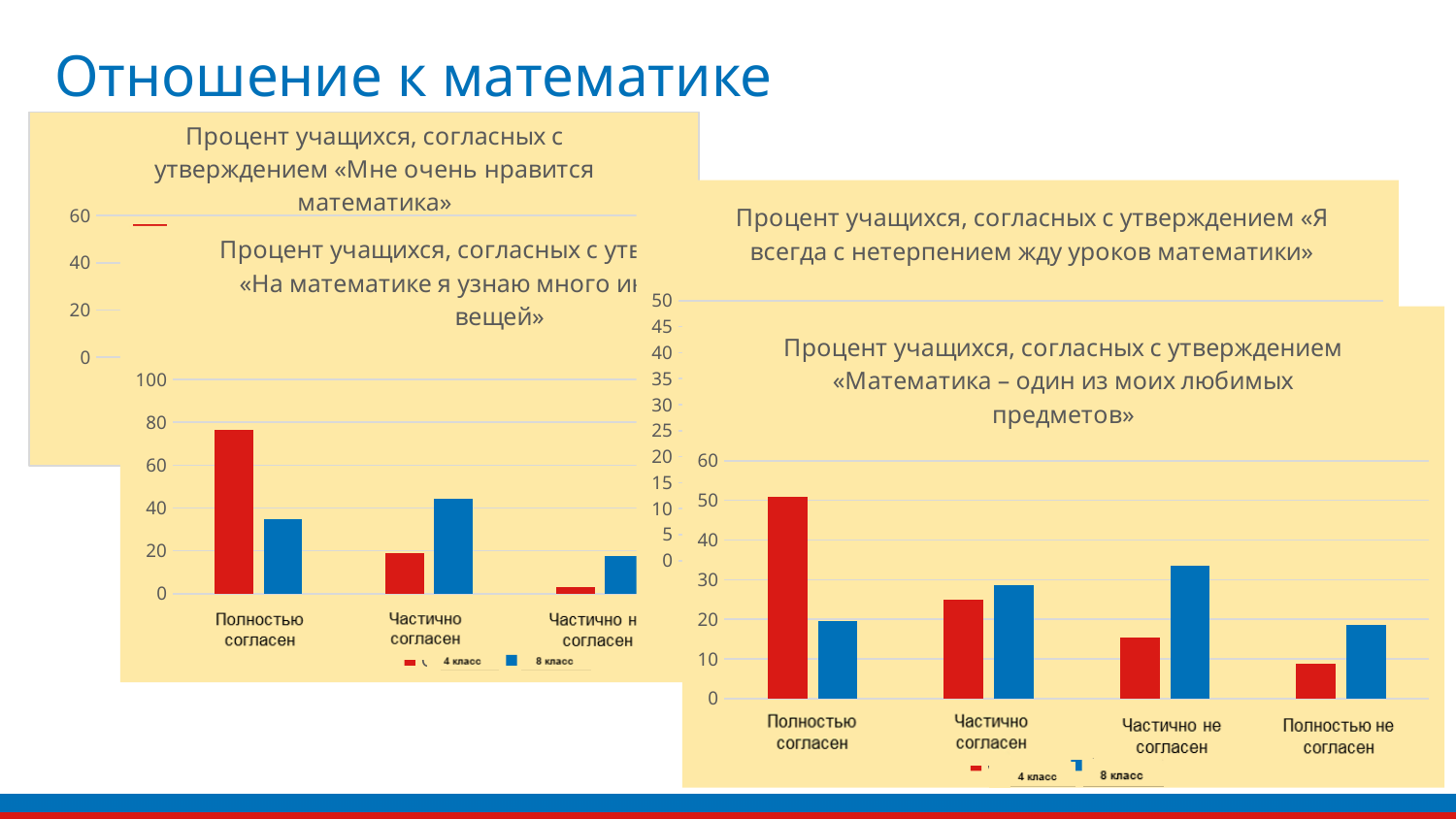
In the chart titled «На математике я узнаю много интересных вещей», which is larger in the category «Частично согласен»: 4 класс or 8 класс? 8 класс How many categories are shown on the x axis of the chart titled «Математика – один из моих любимых предметов»? 4 In the chart titled «Математика – один из моих любимых предметов», which category has the highest value for 8 класс? Частично не согласен In the chart titled «Математика – один из моих любимых предметов», which is larger in the category «Частично не согласен»: 4 класс or 8 класс? 8 класс In the chart titled «Математика – один из моих любимых предметов», which category has the lowest value for 4 класс? Полностью не согласен How many series does the legend list in the chart titled «Математика – один из моих любимых предметов»? 2 In the chart titled «На математике я узнаю много интересных вещей», is the value for 4 класс in the category «Полностью согласен» greater or less than 60? greater What kind of chart is the chart titled «Математика – один из моих любимых предметов»? bar chart In the chart titled «Математика – один из моих любимых предметов», which category has the highest value for 4 класс? Полностью согласен In the chart titled «Математика – один из моих любимых предметов», do the values for 4 класс rise or fall from left to right along the x axis? fall